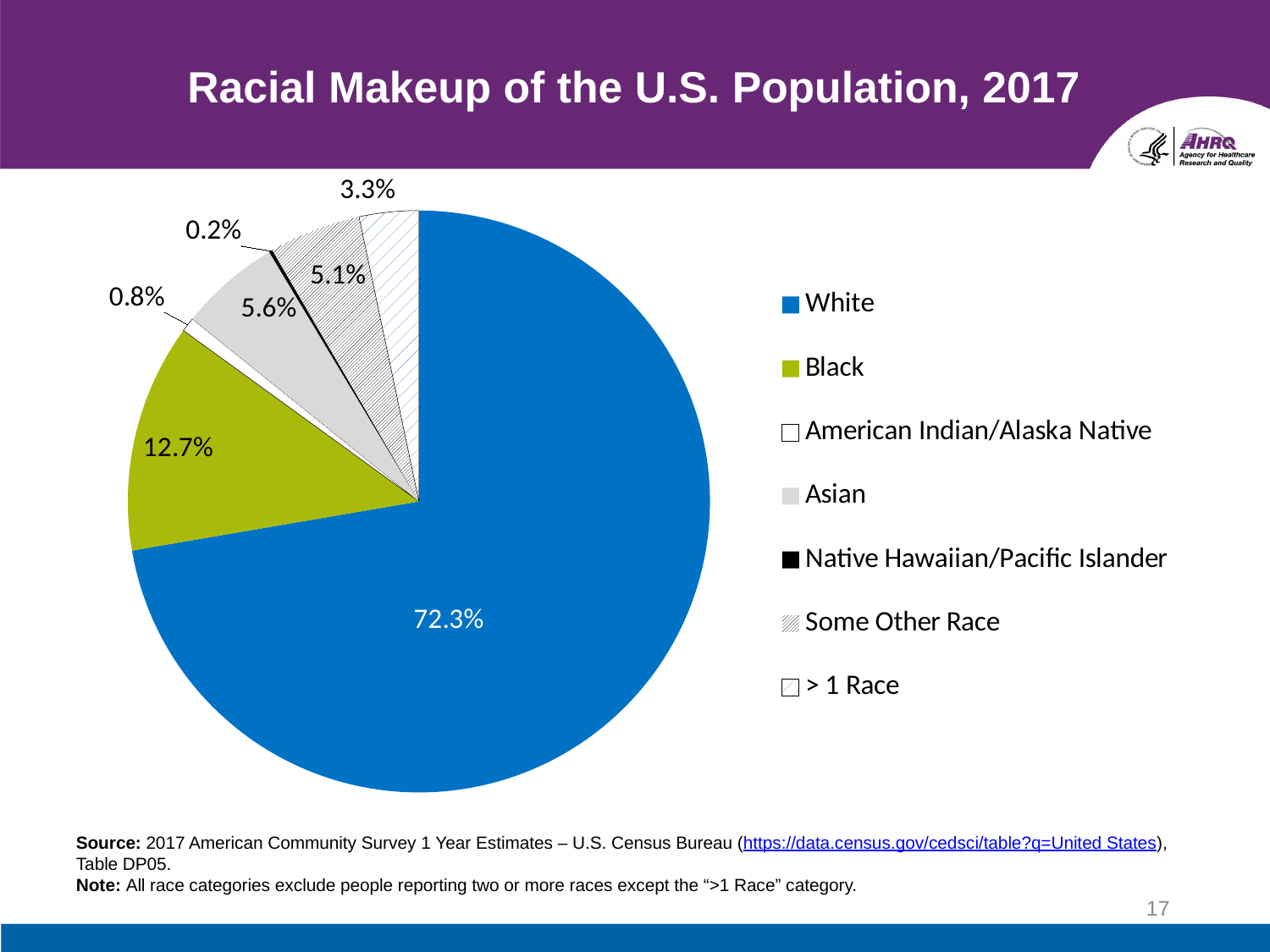
How many race categories does the legend list? 7 What is the difference in percentage points between the White and Black shares? 59.6 What percentage of the U.S. population is Black according to the chart? 12.7% What percentage is shown for the > 1 Race category? 3.3% What percentage of the U.S. population is White according to the chart? 72.3% What percentage is shown for Native Hawaiian/Pacific Islander? 0.2% Which is larger, the share for Asian or the share for Some Other Race? Asian What is the title of the chart? Racial Makeup of the U.S. Population, 2017 Which race category has the largest share of the pie? White What percentage is shown for Asian? 5.6% What kind of chart is shown on the slide? Pie chart Which race category has the smallest share of the pie? Native Hawaiian/Pacific Islander